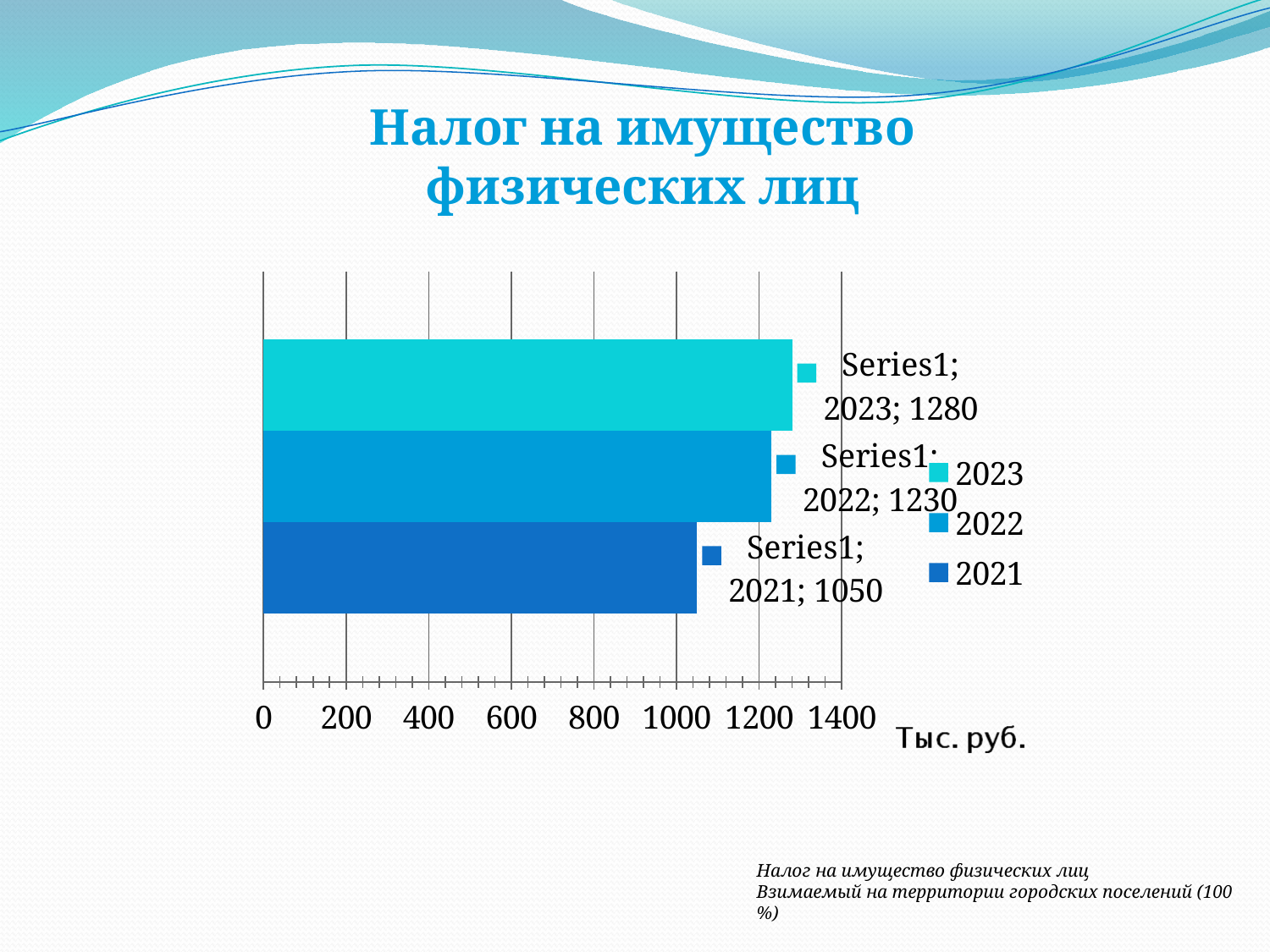
Which is larger, the value for 2022 or the value for 2021? 2022 Which year has the lowest value? 2021 What unit is shown on the horizontal axis of the chart? Тыс. руб. What is the difference between the values for 2022 and 2021? 180 Is the value for 2021 greater or less than 1000? greater What kind of chart is shown on the slide? bar chart How many bars are shown in the chart? 3 What is the value for 2022? 1230 What is the difference between the values for 2023 and 2021? 230 What is the value for 2021? 1050 What is the value for 2023? 1280 Which year has the highest value? 2023